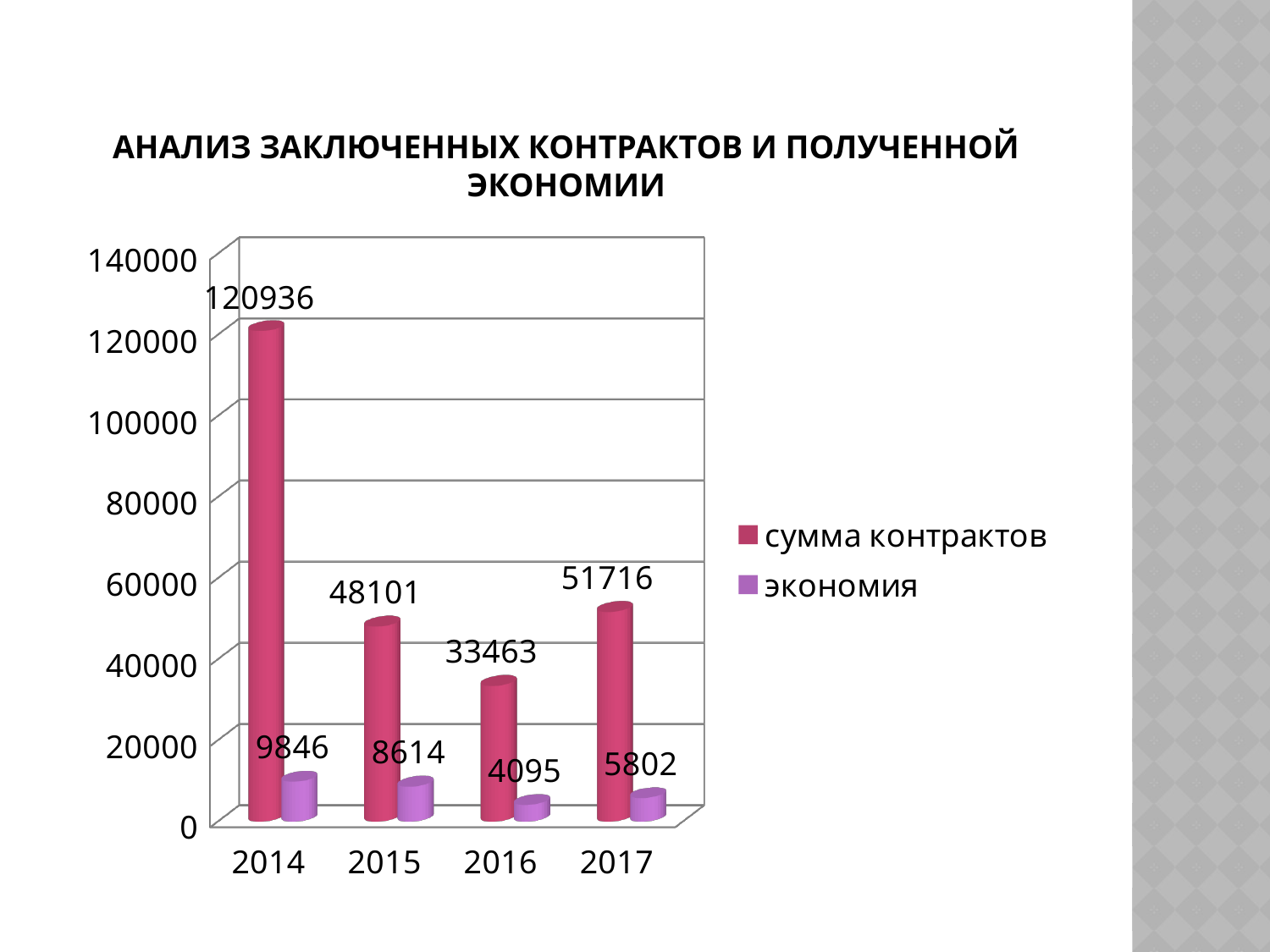
What kind of chart is shown on the slide? bar chart What is the value of экономия for 2016? 4095 Which is larger: экономия in 2014 or экономия in 2015? 2014 What is the title of the chart? АНАЛИЗ ЗАКЛЮЧЕННЫХ КОНТРАКТОВ И ПОЛУЧЕННОЙ ЭКОНОМИИ Which year has the highest сумма контрактов? 2014 Which year has the lowest экономия? 2016 How many series does the legend list? 2 What is the value of сумма контрактов for 2014? 120936 What is the value of сумма контрактов for 2017? 51716 How many years are shown on the x axis? 4 What is the difference between сумма контрактов in 2015 and 2016? 14638 Is the value of сумма контрактов for 2016 greater or less than 40000? less